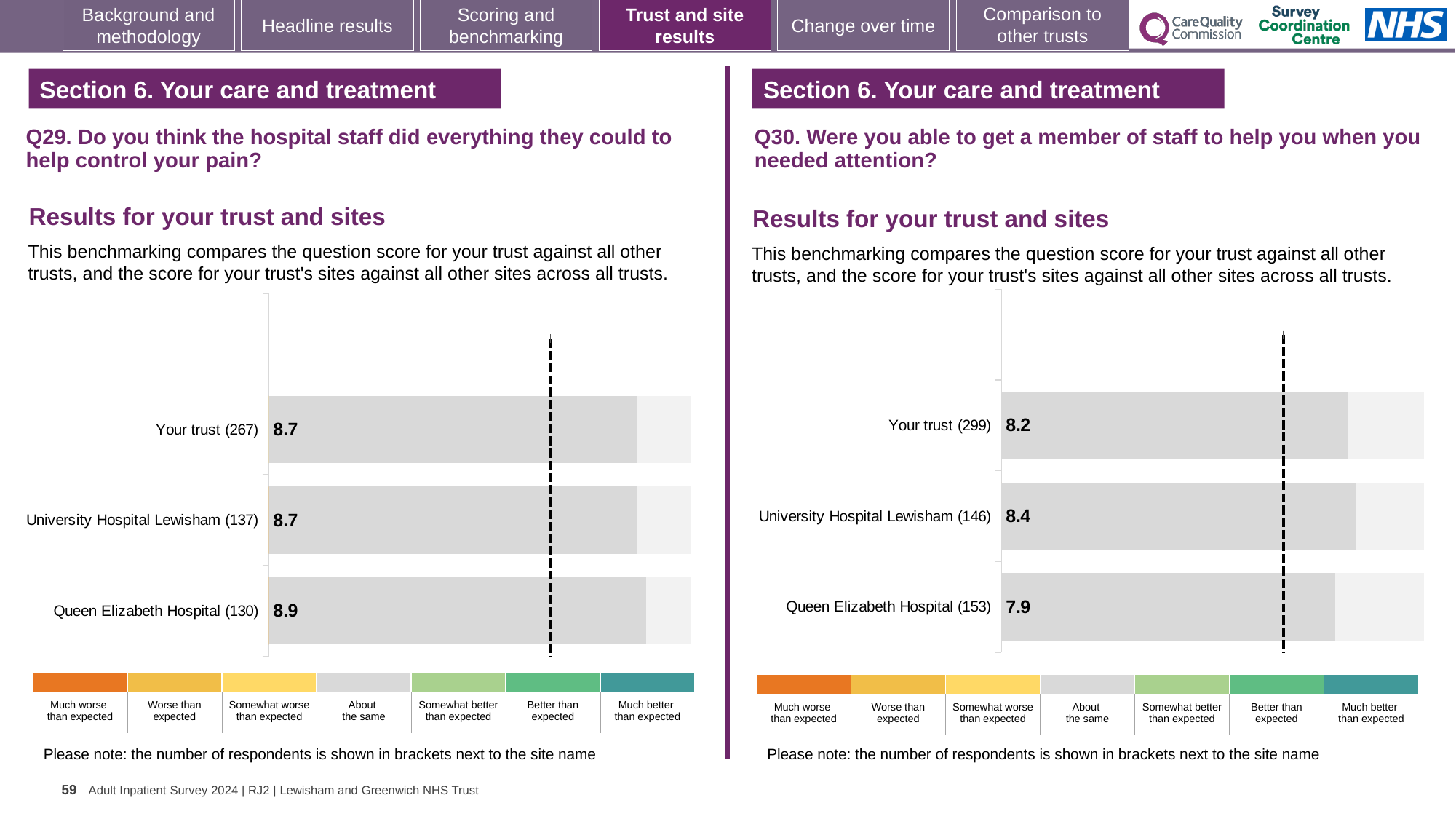
In the Q29 chart on the left, how many bars are plotted? 3 In the Q29 chart on the left, which site or trust has the highest score? Queen Elizabeth Hospital In the Q30 chart on the right, which site or trust has the lowest score? Queen Elizabeth Hospital In the Q29 chart on the left, what is the difference between the scores for Queen Elizabeth Hospital and University Hospital Lewisham? 0.2 In the Q29 chart on the left, what is the score for Queen Elizabeth Hospital? 8.9 In the Q30 chart on the right, what is the difference between the scores for University Hospital Lewisham and Queen Elizabeth Hospital? 0.5 In the Q30 chart on the right, what is the score for University Hospital Lewisham? 8.4 In the Q30 chart on the right, what is the score for Queen Elizabeth Hospital? 7.9 In the Q30 chart on the right, which has the larger score: Your trust or University Hospital Lewisham? University Hospital Lewisham In the Q29 chart on the left, what is the score for Your trust? 8.7 In the Q30 chart on the right, how many respondents are shown in brackets for Your trust? 299 What type of chart is used in the Q30 chart on the right? Bar chart